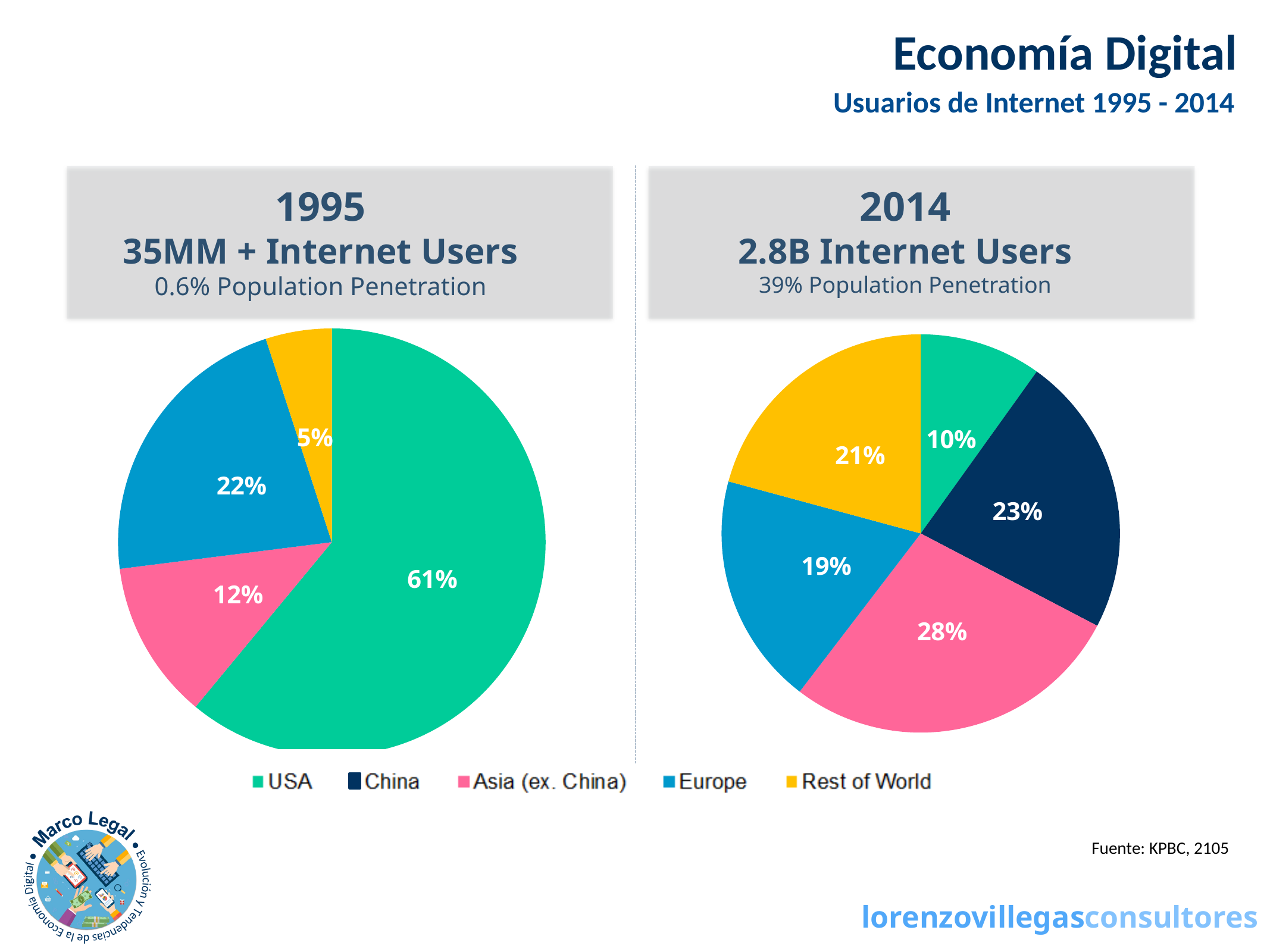
What type of chart is used to show the 2014 internet users by region? Pie chart In the 2014 pie chart, which region has the largest share? Asia (ex. China) In the 2014 pie chart, what share of internet users is China? 23% How many slices does the 1995 pie chart have? 4 In the 2014 pie chart, which region has the smallest share? USA In the 1995 pie chart, which region has the largest share? USA What is the difference between the USA share in the 1995 pie chart and the USA share in the 2014 pie chart? 51% In the 1995 pie chart, what share of internet users is Europe? 22% In the 2014 pie chart, which is larger: the share for Europe or the share for Rest of World? Rest of World In the 1995 pie chart, what share of internet users is USA? 61% In the 2014 pie chart, what share of internet users is Asia (ex. China)? 28% In the 1995 pie chart, which region has the smallest share? Rest of World